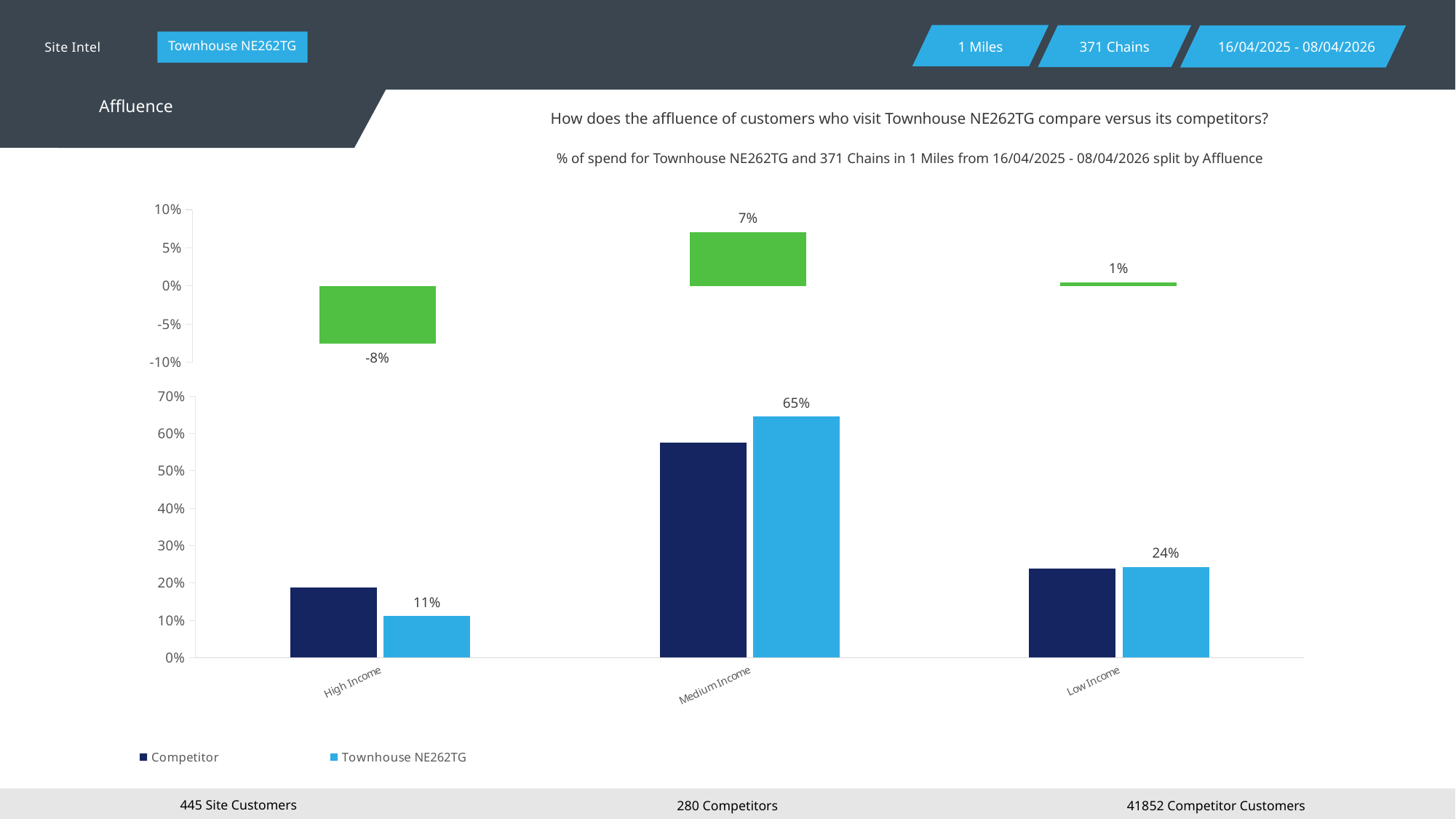
In the bottom chart, what is the difference between the Townhouse NE262TG values for Medium Income and Low Income? 41 percentage points In the bottom chart, which is larger for High Income: Competitor or Townhouse NE262TG? Competitor In the bottom chart, which category has the highest value for Townhouse NE262TG? Medium Income In the top chart, which category has the highest value? Medium Income In the top chart, what is the value shown for High Income? -8% In the bottom chart, what is the value for Townhouse NE262TG in the High Income category? 11% In the bottom chart, what is the value for Townhouse NE262TG in the Medium Income category? 65% In the bottom chart, is the Competitor value for Medium Income greater or less than 50%? greater How many series does the legend of the bottom chart list? 2 In the bottom chart, which is larger for Medium Income: Competitor or Townhouse NE262TG? Townhouse NE262TG In the top chart, which category has the lowest value? High Income In the top chart, what is the value shown for Medium Income? 7%